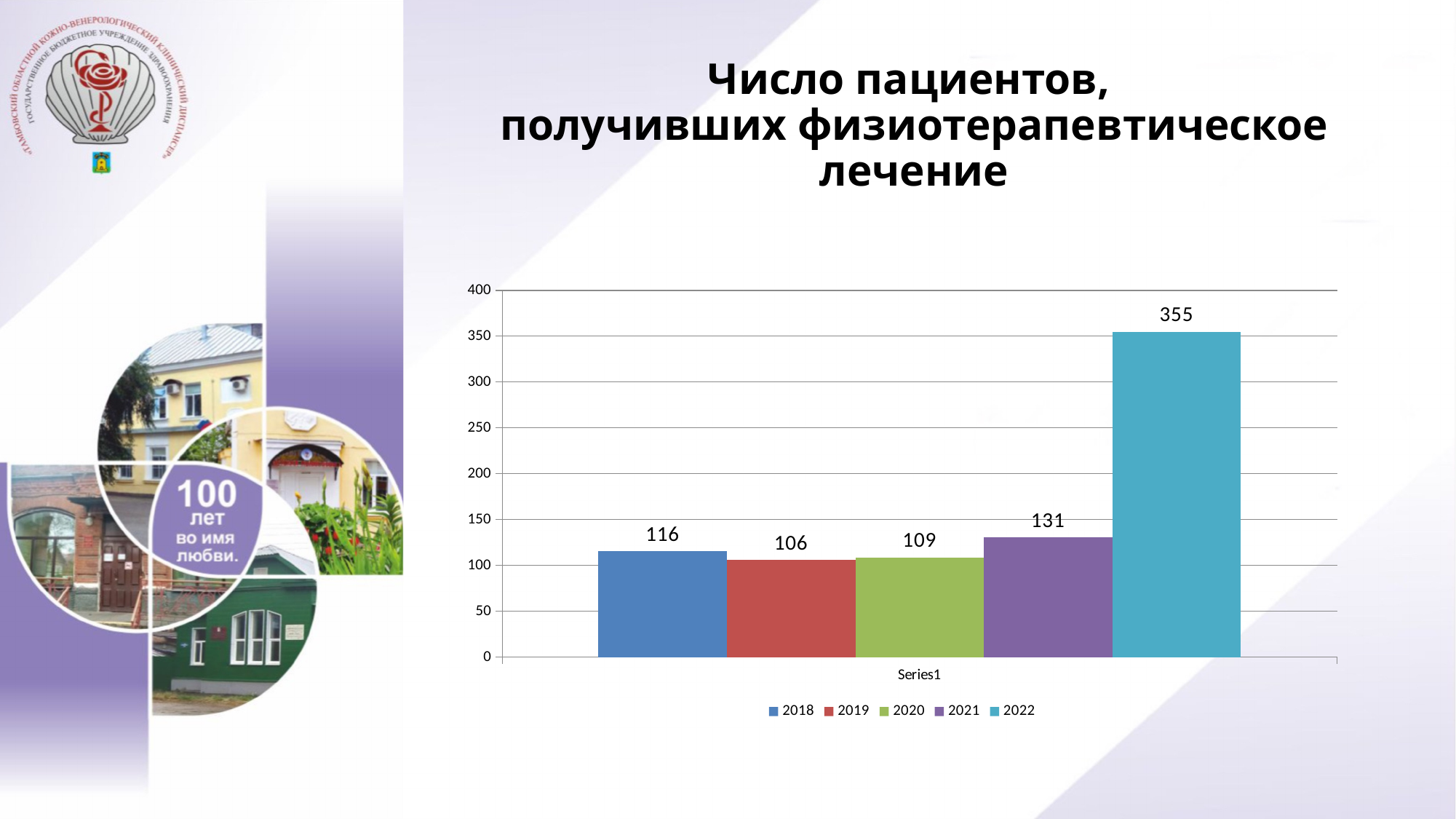
What is the value for 2019? 106 Which year has the highest value? 2022 Which year has the lowest value? 2019 What is the difference between the values for 2018 and 2020? 7 What is the value for 2022? 355 What is the difference between the values for 2022 and 2021? 224 What colour is the bar for 2022? teal What is the value for 2018? 116 Which is larger, the value for 2021 or the value for 2018? 2021 Is the value for 2022 greater or less than 300? greater How many series does the legend list? 5 What kind of chart is shown on the slide? bar chart